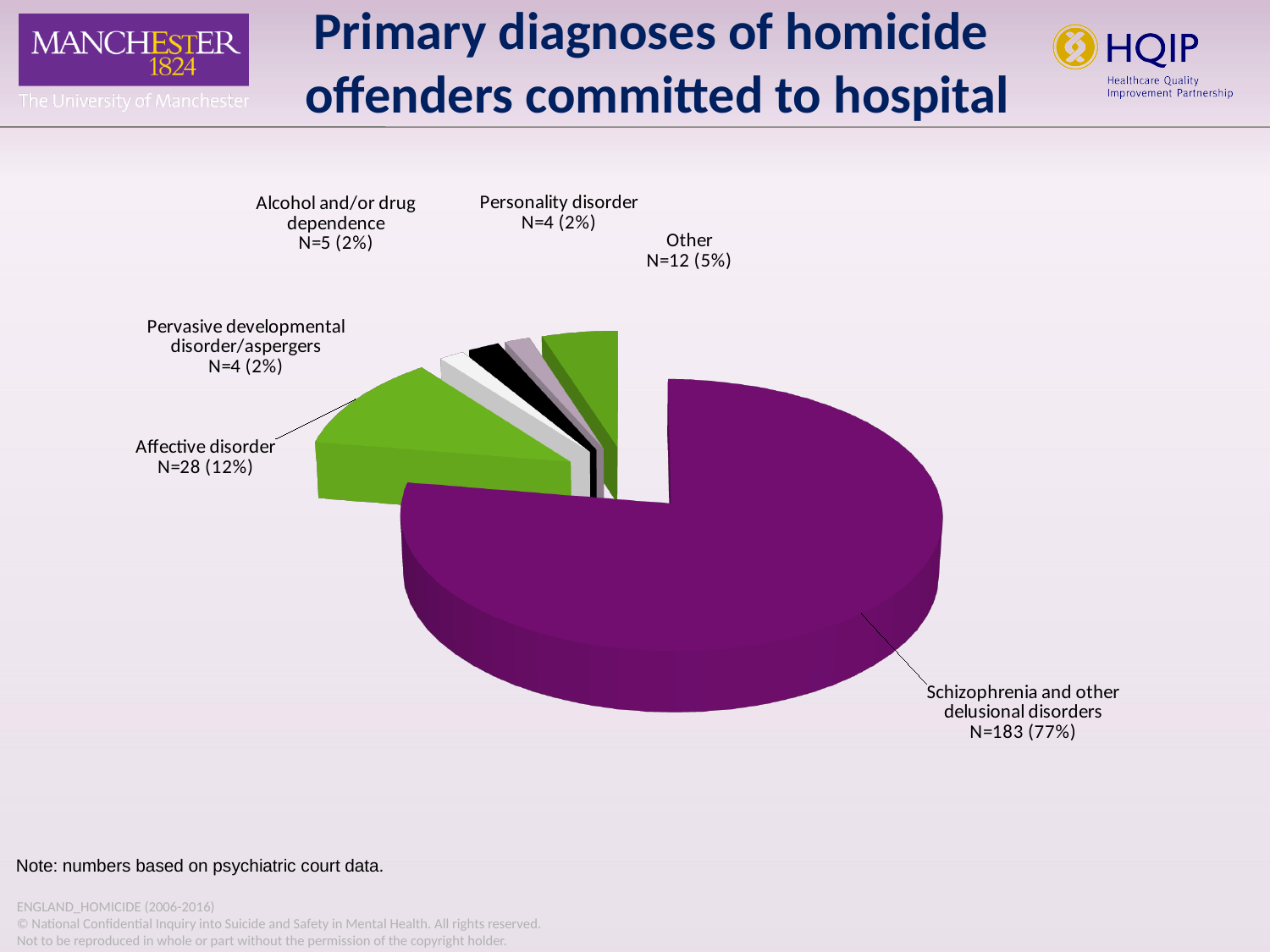
What is the title of the slide? Primary diagnoses of homicide offenders committed to hospital What is the N value for Schizophrenia and other delusional disorders? N=183 (77%) What is the N value for Affective disorder? N=28 (12%) What is the N value for Alcohol and/or drug dependence? N=5 (2%) What kind of chart is shown on the slide? Pie chart Which has a larger N, Other or Alcohol and/or drug dependence? Other What is the difference in N between Schizophrenia and other delusional disorders and Affective disorder? 155 What is the N value for Other? N=12 (5%) What percentage share of the pie does Affective disorder have? 12% What is the difference in N between Other and Personality disorder? 8 How many diagnosis categories are shown in the pie chart? 6 Which diagnosis has the largest share of the pie? Schizophrenia and other delusional disorders